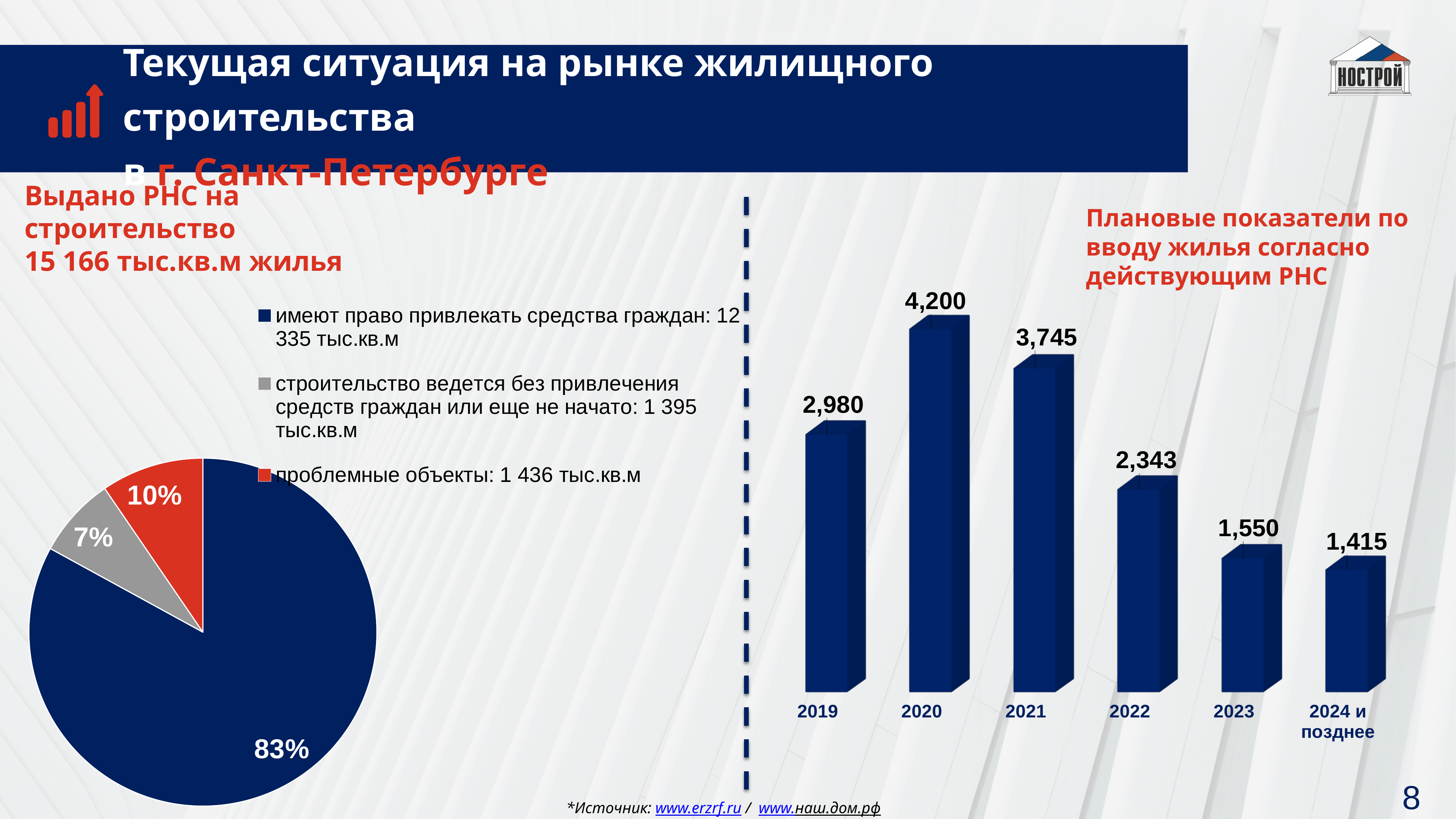
In the bar chart on the right, which year has the highest value? 2020 In the pie chart on the left, what share is shown for the largest slice (имеют право привлекать средства граждан)? 83% In the bar chart on the right, which is larger: the value for 2019 or the value for 2022? 2019 How many bars are in the bar chart on the right? 6 In the bar chart on the right, what is the value for 2023? 1,550 What kind of chart is shown on the right side of the slide? bar chart How many entries does the legend of the pie chart on the left list? 3 In the pie chart on the left, what share is labelled for проблемные объекты (the red slice)? 10% In the bar chart on the right, which category has the lowest value? 2024 и позднее In the bar chart on the right, do the values rise or fall from 2020 to 2024 и позднее? fall In the bar chart on the right, what is the difference between the values for 2020 and 2021? 455 In the bar chart on the right, what is the value for 2020? 4,200